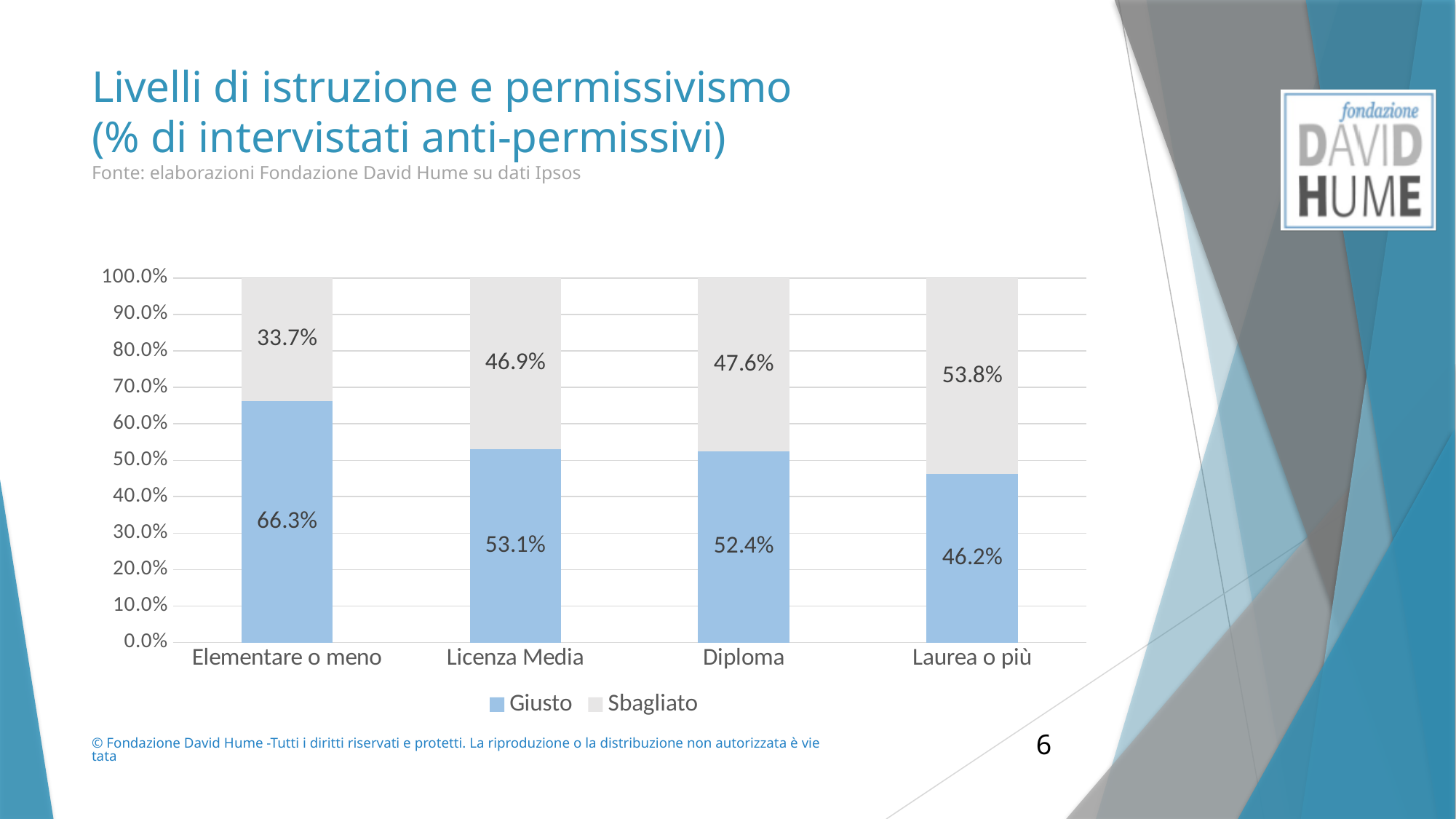
What kind of chart is shown on the slide? Stacked bar chart What is the Sbagliato value for Licenza Media? 46.9% What is the Giusto value for Elementare o meno? 66.3% Which education level has the lowest Sbagliato value? Elementare o meno What is the Giusto value for Diploma? 52.4% Which is larger: the Sbagliato value for Laurea o più or the Sbagliato value for Elementare o meno? Laurea o più How many series does the legend list? 2 How many education levels are shown on the x axis? 4 What is the Sbagliato value for Laurea o più? 53.8% Does the Giusto value rise or fall as education level increases from Elementare o meno to Laurea o più? Falls Which education level has the highest Giusto value? Elementare o meno What is the difference between the Giusto values for Elementare o meno and Laurea o più? 20.1%